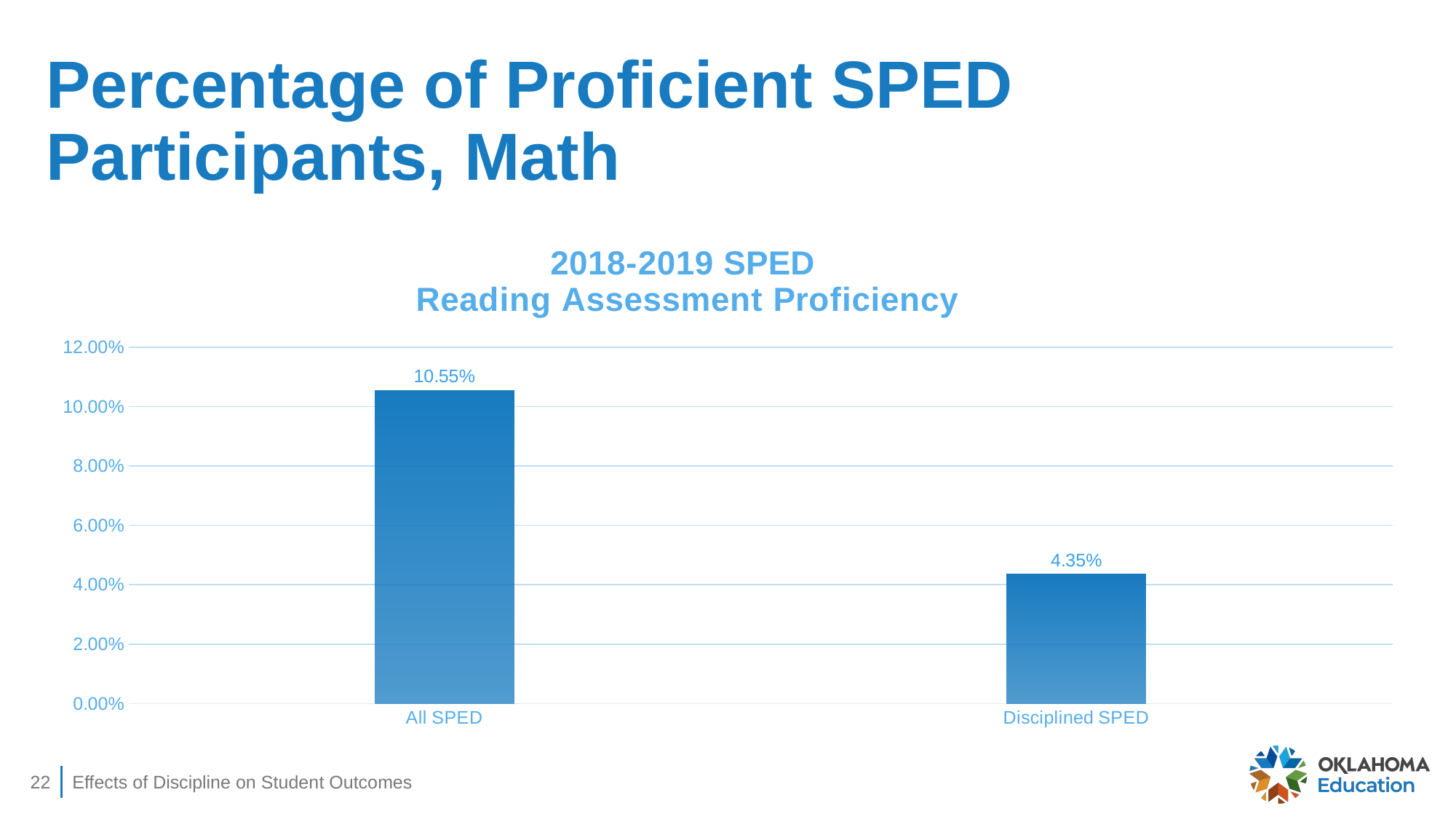
How many categories are shown in the chart? 2 What is the value for Disciplined SPED? 4.35% Is the value for Disciplined SPED greater or less than 6.00%? less Which category has the highest value? All SPED What kind of chart is shown on the slide? Bar chart What is the value for All SPED? 10.55% What is the title of the chart? 2018-2019 SPED Reading Assessment Proficiency What is the difference between the All SPED and Disciplined SPED values? 6.20% Which category has the lowest value? Disciplined SPED Is the value for All SPED greater or less than 10.00%? greater What is the highest value shown on the vertical axis? 12.00% Which is larger, the value for All SPED or the value for Disciplined SPED? All SPED